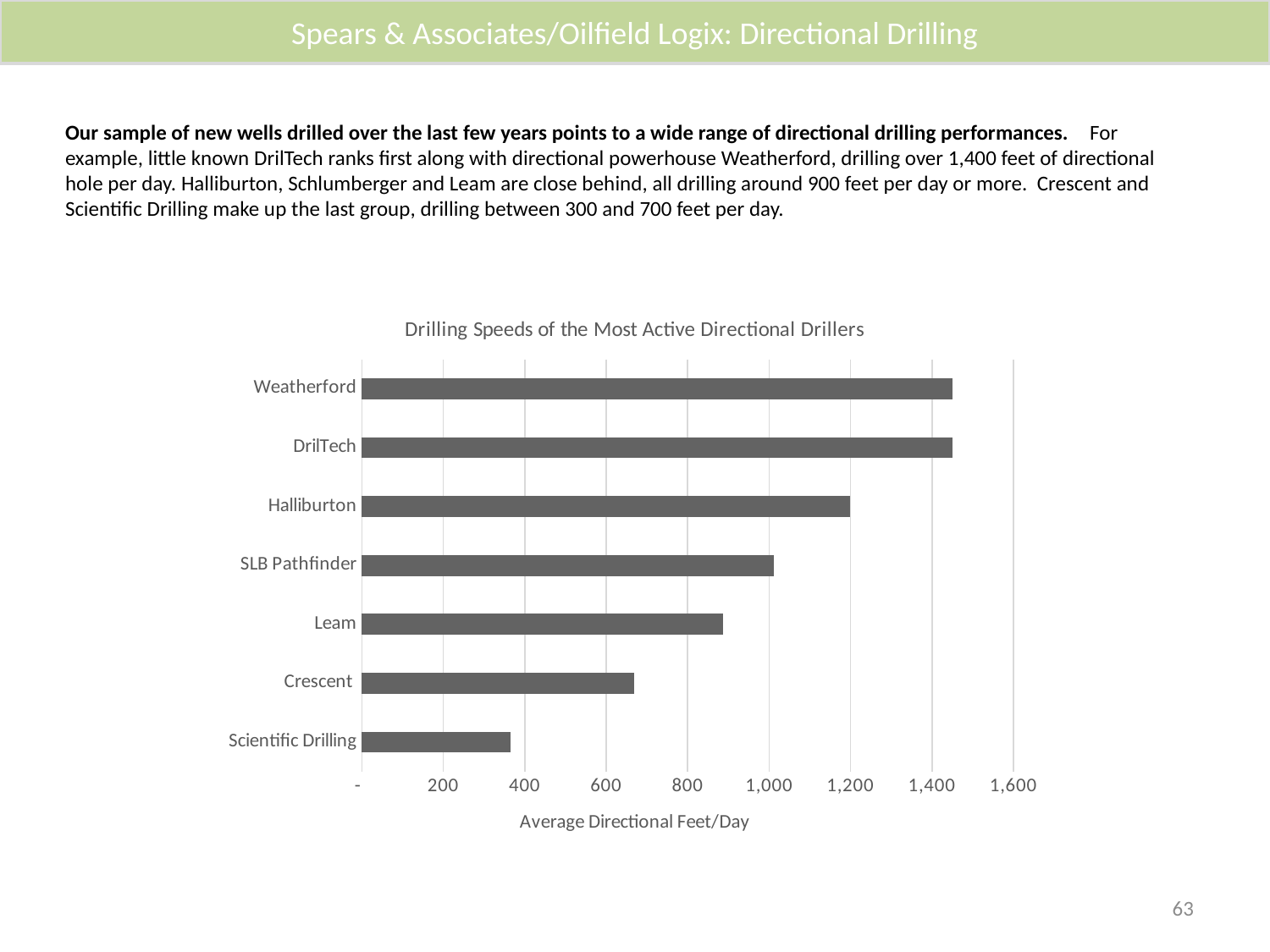
Is the value for Leam greater or less than 1,000? less Which has a higher average directional feet per day, Crescent or Scientific Drilling? Crescent Which has a higher average directional feet per day, Halliburton or Leam? Halliburton What is the title of the chart? Drilling Speeds of the Most Active Directional Drillers Is the value for Crescent greater or less than 800? less Is the value for Halliburton greater or less than 1,000? greater Which driller has the lowest average directional feet per day? Scientific Drilling How many drillers are plotted in the chart? 7 What kind of chart is shown on the slide? Bar chart